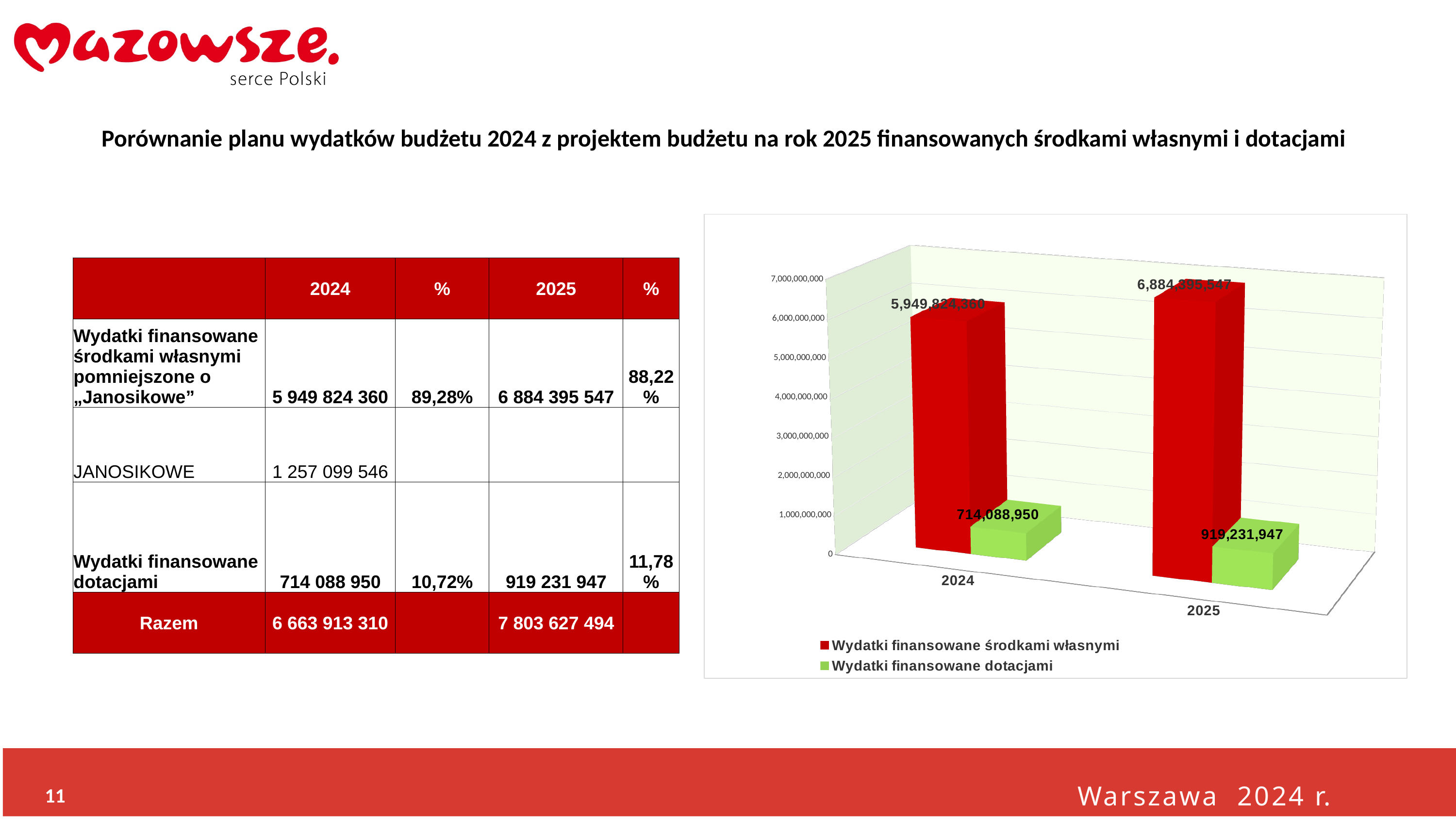
What is the difference between the 2025 and 2024 values for Wydatki finansowane dotacjami on the chart? 205,142,997 What is the value for Wydatki finansowane środkami własnymi in 2025 on the chart? 6,884,395,547 Which year has the higher value for Wydatki finansowane środkami własnymi on the chart? 2025 What is the value for Wydatki finansowane dotacjami in 2024 on the chart? 714,088,950 How many series does the chart legend list? 2 What is the value for Wydatki finansowane dotacjami in 2025 on the chart? 919,231,947 What kind of chart is shown on the slide? bar chart Is the 2025 value for Wydatki finansowane dotacjami greater or less than 1,000,000,000? less What is the value for Wydatki finansowane środkami własnymi in 2024 on the chart? 5,949,824,360 By how much does Wydatki finansowane środkami własnymi increase from 2024 to 2025 on the chart? 934,571,187 Do the values for Wydatki finansowane środkami własnymi rise or fall from 2024 to 2025? rise Which year has the lower value for Wydatki finansowane dotacjami on the chart? 2024